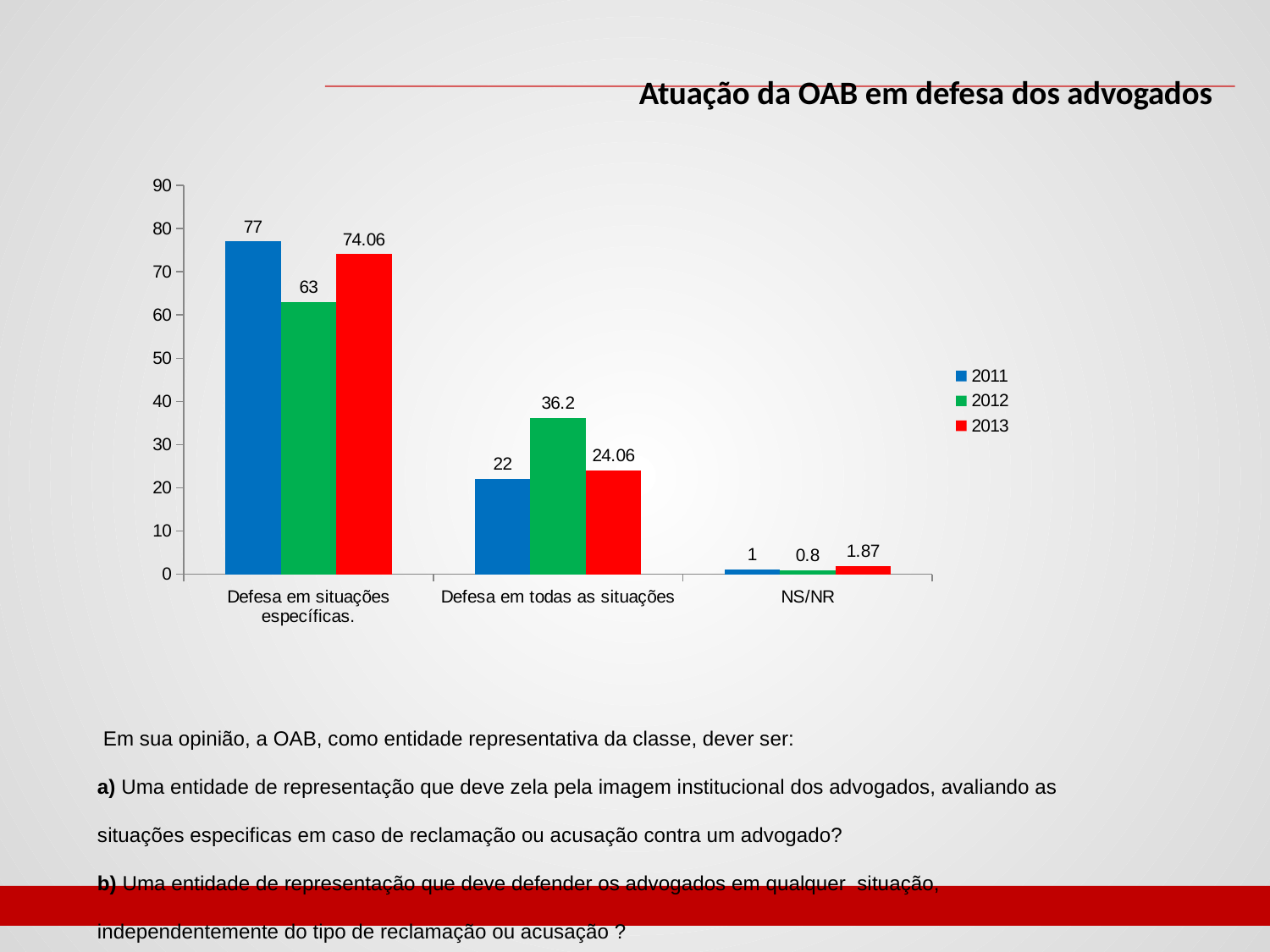
Which year has the highest value in the 'Defesa em todas as situações' category? 2012 What is the difference between the 2011 and 2012 values in the 'Defesa em situações específicas.' category? 14 Which category has the lowest values across all years? NS/NR Is the 2012 value for 'Defesa em todas as situações' greater or less than 30? greater What is the title of the chart? Atuação da OAB em defesa dos advogados What is the value for 2011 in the 'Defesa em situações específicas.' category? 77 What is the value for 2013 in the 'Defesa em todas as situações' category? 24.06 What is the value for 2012 in the NS/NR category? 0.8 Which is larger in the 'Defesa em situações específicas.' category: the 2012 value or the 2013 value? 2013 What kind of chart is shown on the slide? bar chart How many series does the legend list? 3 How many categories are shown on the x axis? 3